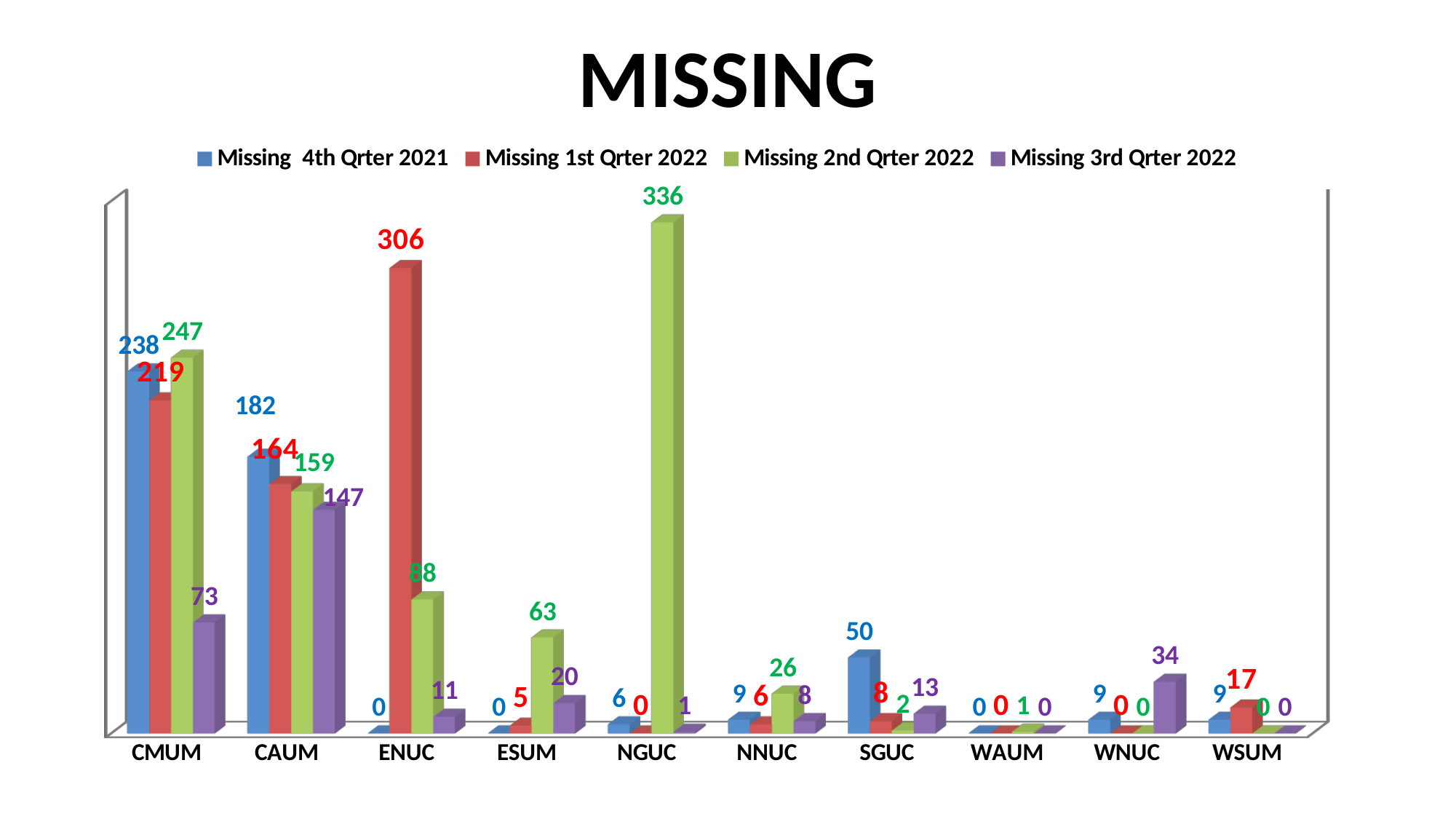
What is the value for ENUC in the Missing 1st Qrter 2022 series? 306 What kind of chart is shown on the slide? Bar chart What is the difference between the Missing 1st Qrter 2022 values for ENUC and CAUM? 142 Which category has the highest value in the Missing 2nd Qrter 2022 series? NGUC What is the value for CMUM in the Missing 2nd Qrter 2022 series? 247 What is the value for WNUC in the Missing 3rd Qrter 2022 series? 34 Which category has the highest value in the Missing 4th Qrter 2021 series? CMUM How many categories are shown on the x axis? 10 Which is larger for SGUC: the Missing 4th Qrter 2021 value or the Missing 3rd Qrter 2022 value? Missing 4th Qrter 2021 What is the difference between the Missing 4th Qrter 2021 value and the Missing 3rd Qrter 2022 value for CMUM? 165 What is the title of the chart? MISSING How many series does the legend list? 4